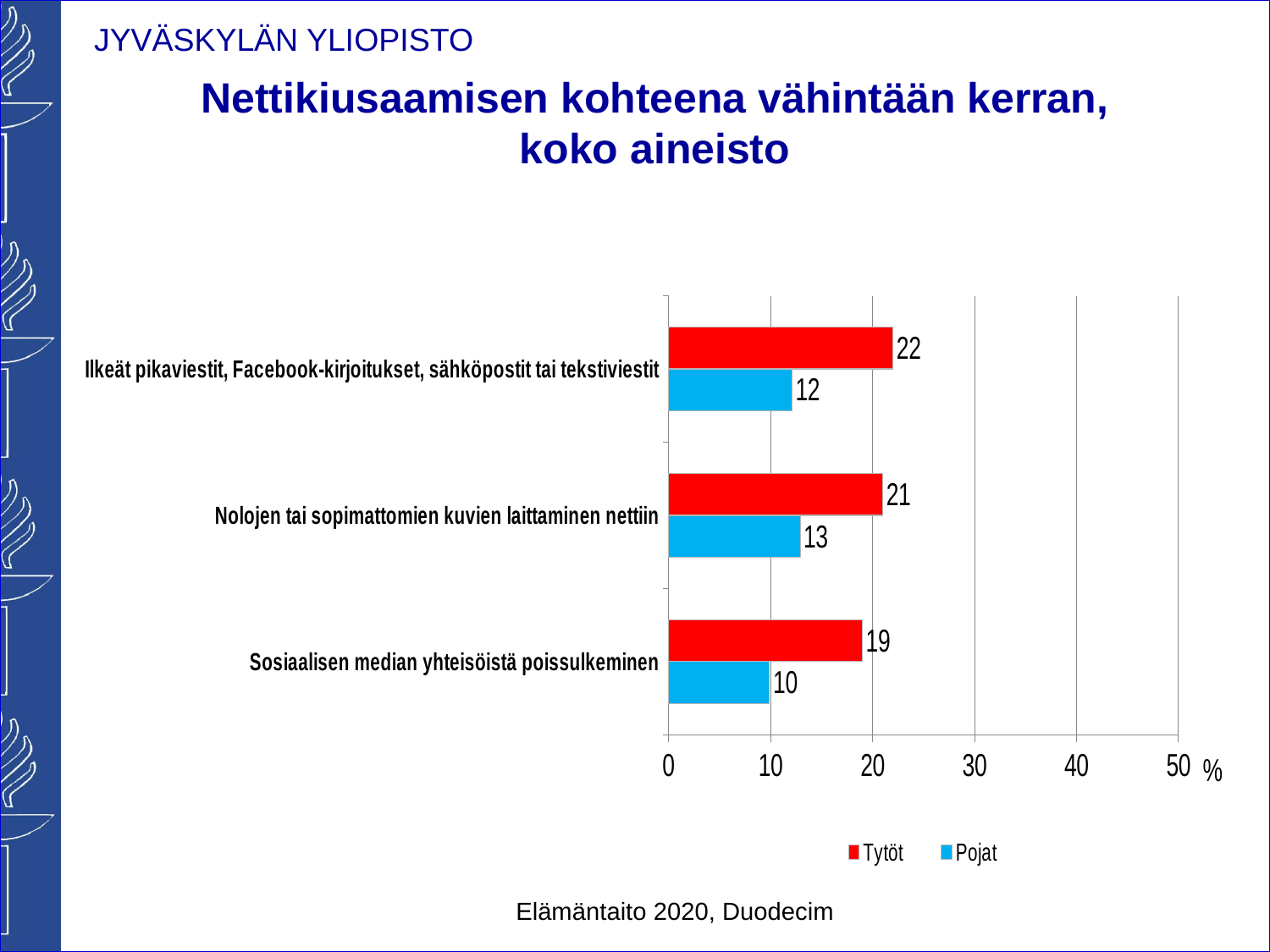
Which is larger for 'Sosiaalisen median yhteisöistä poissulkeminen': Tytöt or Pojat? Tytöt Is the Tytöt value for 'Nolojen tai sopimattomien kuvien laittaminen nettiin' greater or less than 30? less What is the value for Pojat for 'Sosiaalisen median yhteisöistä poissulkeminen'? 10 What is the difference between the Tytöt and Pojat values for 'Ilkeät pikaviestit, Facebook-kirjoitukset, sähköpostit tai tekstiviestit'? 10 What kind of chart is shown on the slide? bar chart Which category has the lowest value for Pojat? Sosiaalisen median yhteisöistä poissulkeminen How many series does the legend list? 2 Which colour represents Pojat in the chart? blue Which category has the highest value for Tytöt? Ilkeät pikaviestit, Facebook-kirjoitukset, sähköpostit tai tekstiviestit How many categories are shown on the chart? 3 What is the value for Pojat for 'Nolojen tai sopimattomien kuvien laittaminen nettiin'? 13 What is the value for Tytöt for 'Ilkeät pikaviestit, Facebook-kirjoitukset, sähköpostit tai tekstiviestit'? 22